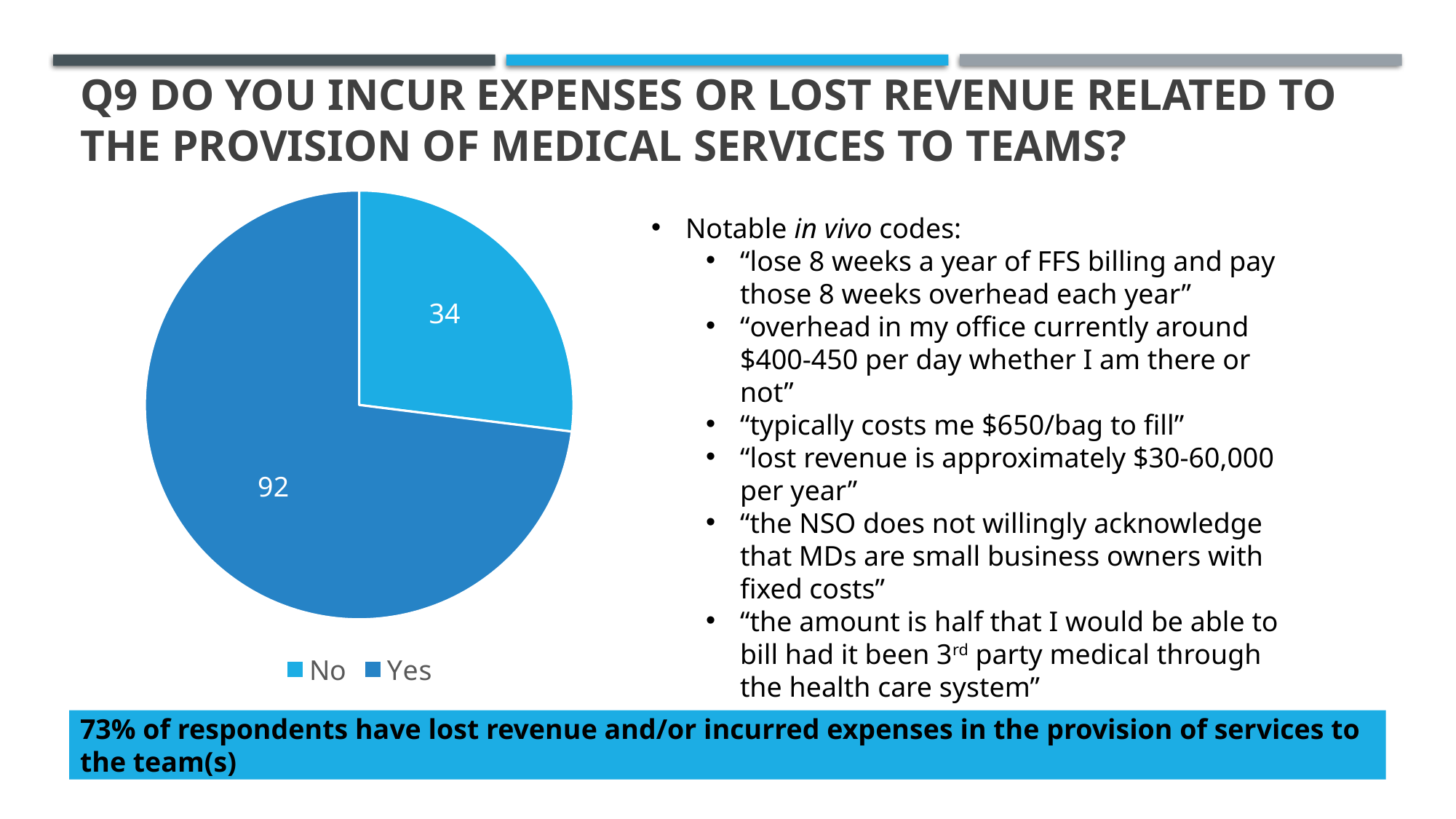
Is the "Yes" slice larger or smaller than the "No" slice? larger Which legend entry is shown in the lighter blue colour? No What is the total number of responses shown in the pie chart? 126 How many respondents answered "Yes" in the pie chart? 92 How many slices does the pie chart have? 2 Which response has the smaller slice in the pie chart? No What share of the pie does the "Yes" slice represent, to the nearest whole percent? 73% How many entries does the legend of the pie chart list? 2 What type of chart is shown on the slide? pie chart What is the difference between the number of "Yes" and "No" responses? 58 How many respondents answered "No" in the pie chart? 34 Which response has the larger slice in the pie chart? Yes